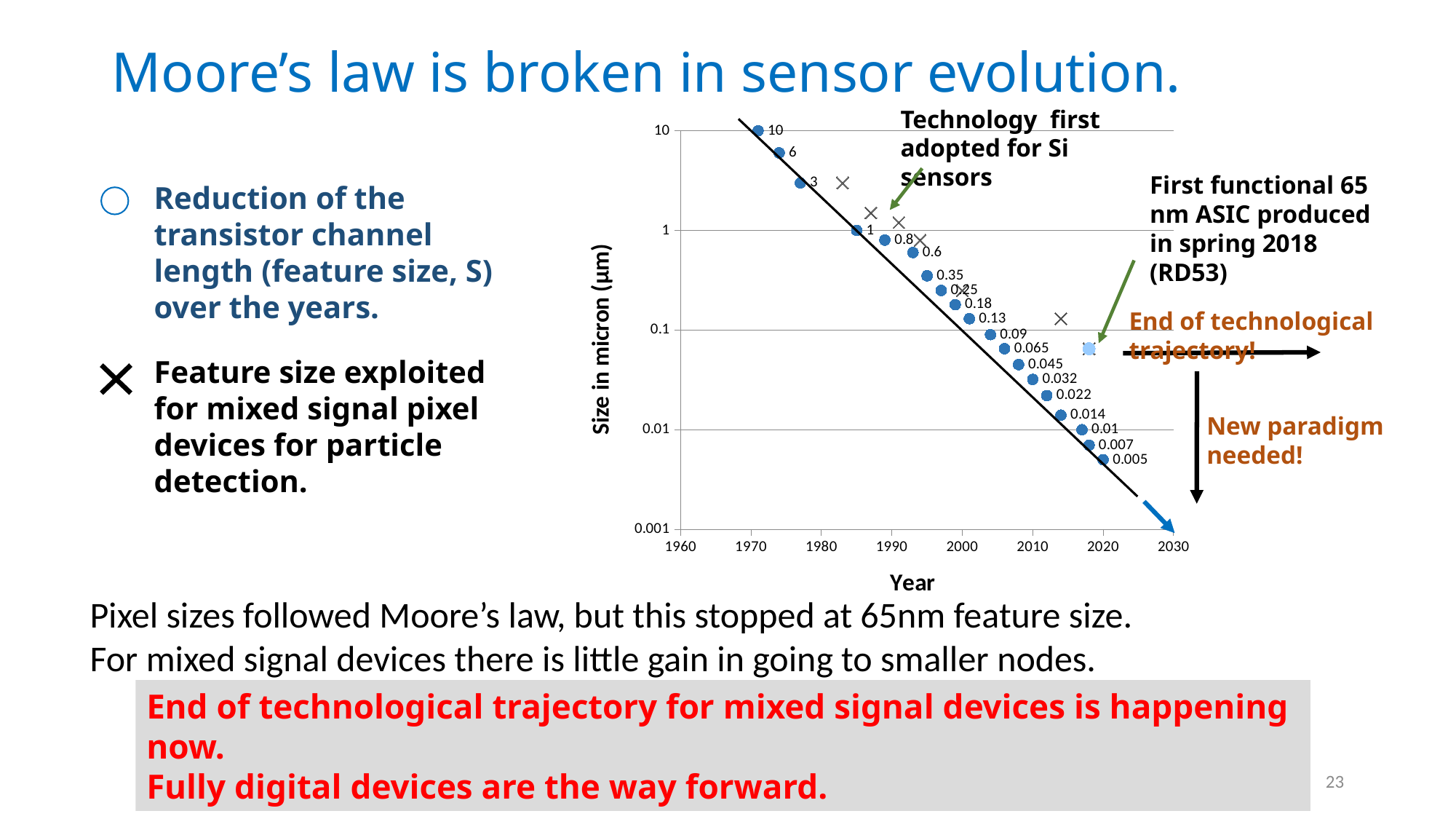
Is the value of the earliest X marker (near 1983) greater or less than 1? greater What kind of chart is shown on the slide? scatter chart What is the label of the x axis of the chart? Year Do the feature size values rise or fall as the year increases along the x axis? fall What is the smallest data label shown on the circle points in the chart? 0.005 What is the largest data label shown on the circle points in the chart? 10 What is the difference between the labelled circle values 0.01 and 0.005? 0.005 What is the label of the y axis of the chart? Size in micron (μm) What is the difference between the two largest labelled circle values, 10 and 6? 4 Is the value of the X marker plotted near 2014 greater or less than 0.1? greater Which labelled circle value is larger, 0.35 or 0.25? 0.35